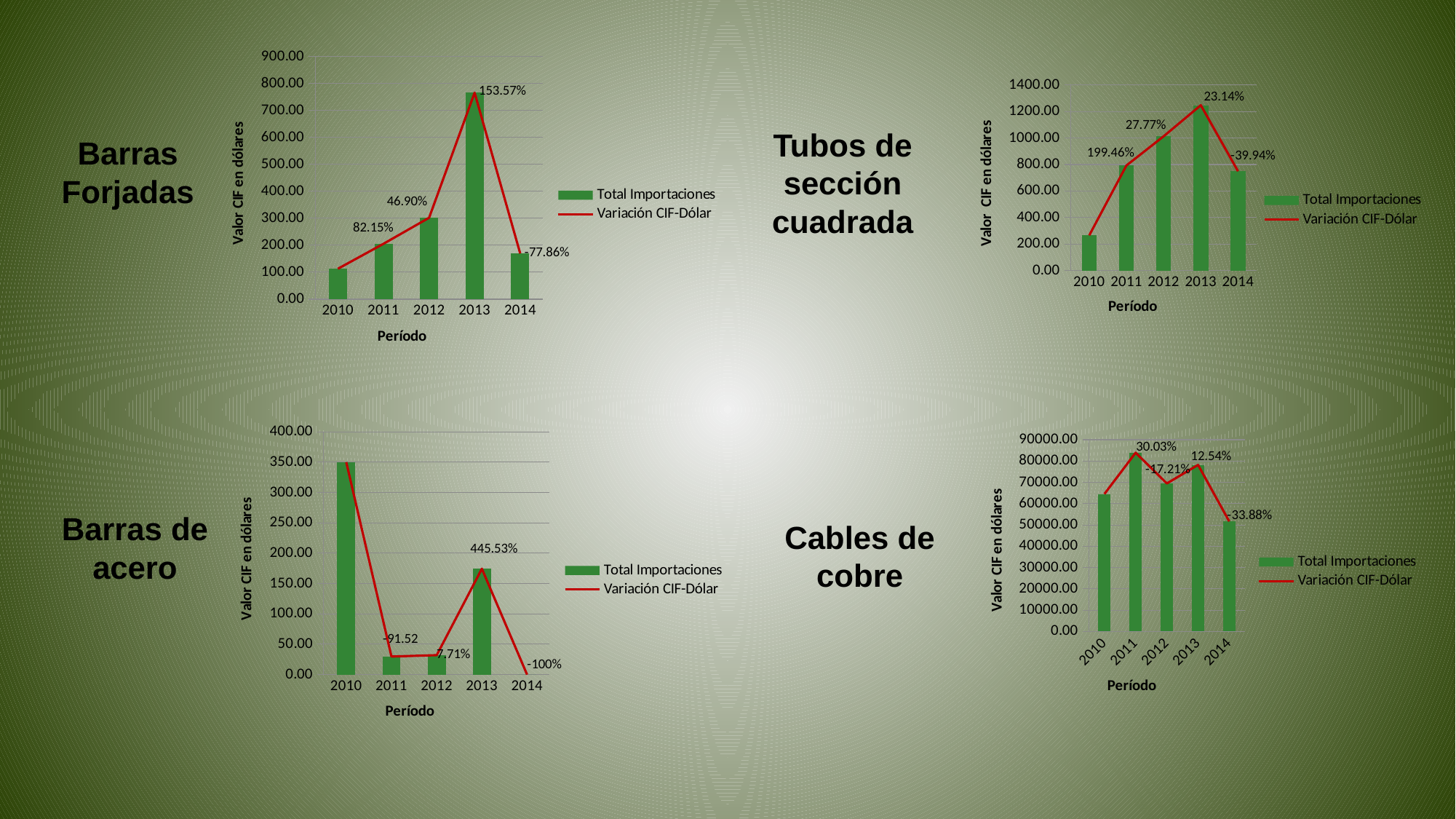
In the Cables de cobre chart, which year has the highest Total Importaciones bar? 2011 In the Barras de acero chart, what is the Variación CIF-Dólar value labelled for 2013? 445.53% In the Cables de cobre chart, is the Total Importaciones value for 2014 greater or less than 60000.00? less In the Tubos de sección cuadrada chart, what is the Variación CIF-Dólar value labelled for 2011? 199.46% In the Barras de acero chart, which year has the highest Total Importaciones bar? 2010 In the Tubos de sección cuadrada chart, is the Total Importaciones value for 2013 greater or less than 1000.00? greater In the Barras Forjadas chart, is the Total Importaciones value for 2012 greater or less than 200.00? greater In the Tubos de sección cuadrada chart, which year has the lowest Total Importaciones bar? 2010 In the Barras Forjadas chart, what is the Variación CIF-Dólar value labelled for 2013? 153.57% In the Cables de cobre chart, what is the Variación CIF-Dólar value labelled for 2014? -33.88% How many series does the legend of the Cables de cobre chart list? 2 In the Barras Forjadas chart, which year has the highest Total Importaciones bar? 2013